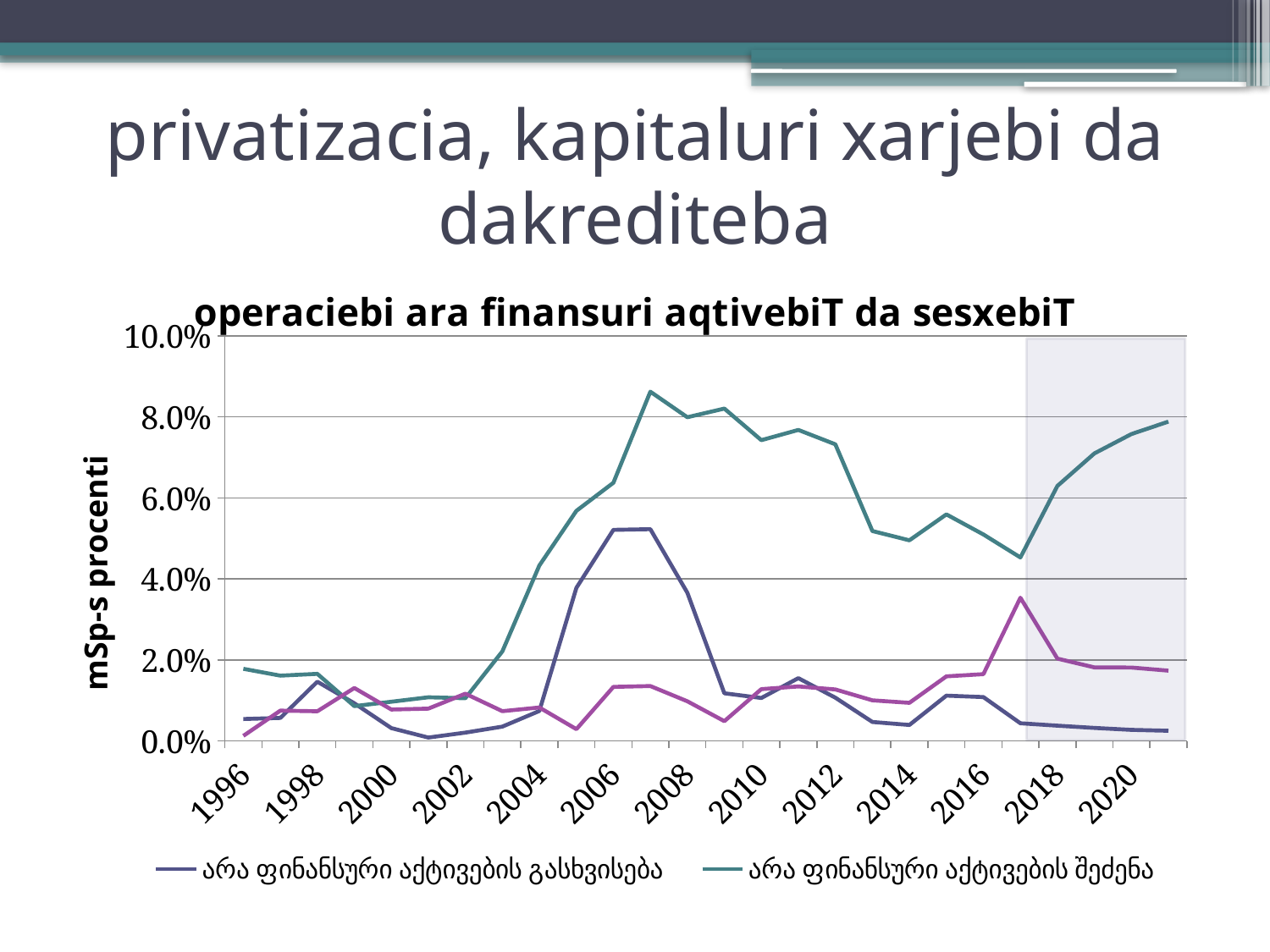
Does the 'არა ფინანსური აქტივების შეძენა' series rise or fall from 2017 to the end of the chart? rise How many series does the chart legend list? 2 What is the label on the vertical axis of the chart? mSp-s procenti In 2007, which series is higher: 'არა ფინანსური აქტივების გასხვისება' or 'არა ფინანსური აქტივების შეძენა'? არა ფინანსური აქტივების შეძენა Is the value of the 'არა ფინანსური აქტივების გასხვისება' series in 2007 greater or less than 4.0%? greater How many year labels are shown on the x axis? 13 Is the value of the 'არა ფინანსური აქტივების შეძენა' series in 2007 greater or less than 8.0%? greater Is the value of the 'არა ფინანსური აქტივების შეძენა' series in 2003 greater or less than 4.0%? less What is the title of the chart? operaciebi ara finansuri aqtivebiT da sesxebiT What kind of chart is shown on the slide? line chart